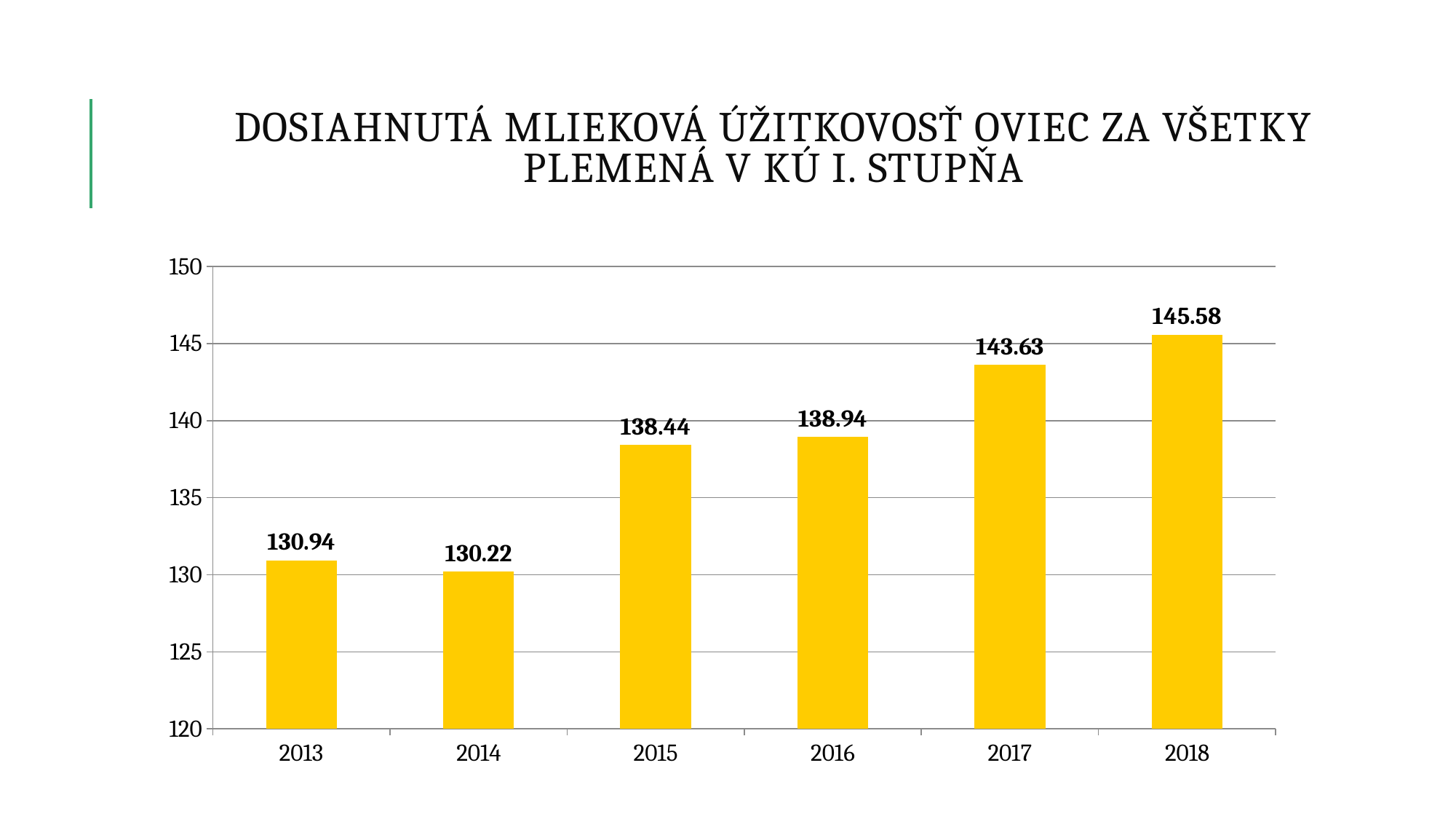
Which is larger, the value for 2015 or the value for 2017? 2017 How many years are shown on the x axis? 6 Do the values generally rise or fall from 2013 to 2018? rise What is the value for 2018? 145.58 What is the difference between the values for 2018 and 2017? 1.95 What kind of chart is shown on the slide? bar chart Is the value for 2017 greater or less than 140? greater What is the difference between the values for 2015 and 2014? 8.22 Which year has the highest value? 2018 Which year has the lowest value? 2014 What is the value for 2016? 138.94 What is the value for 2013? 130.94